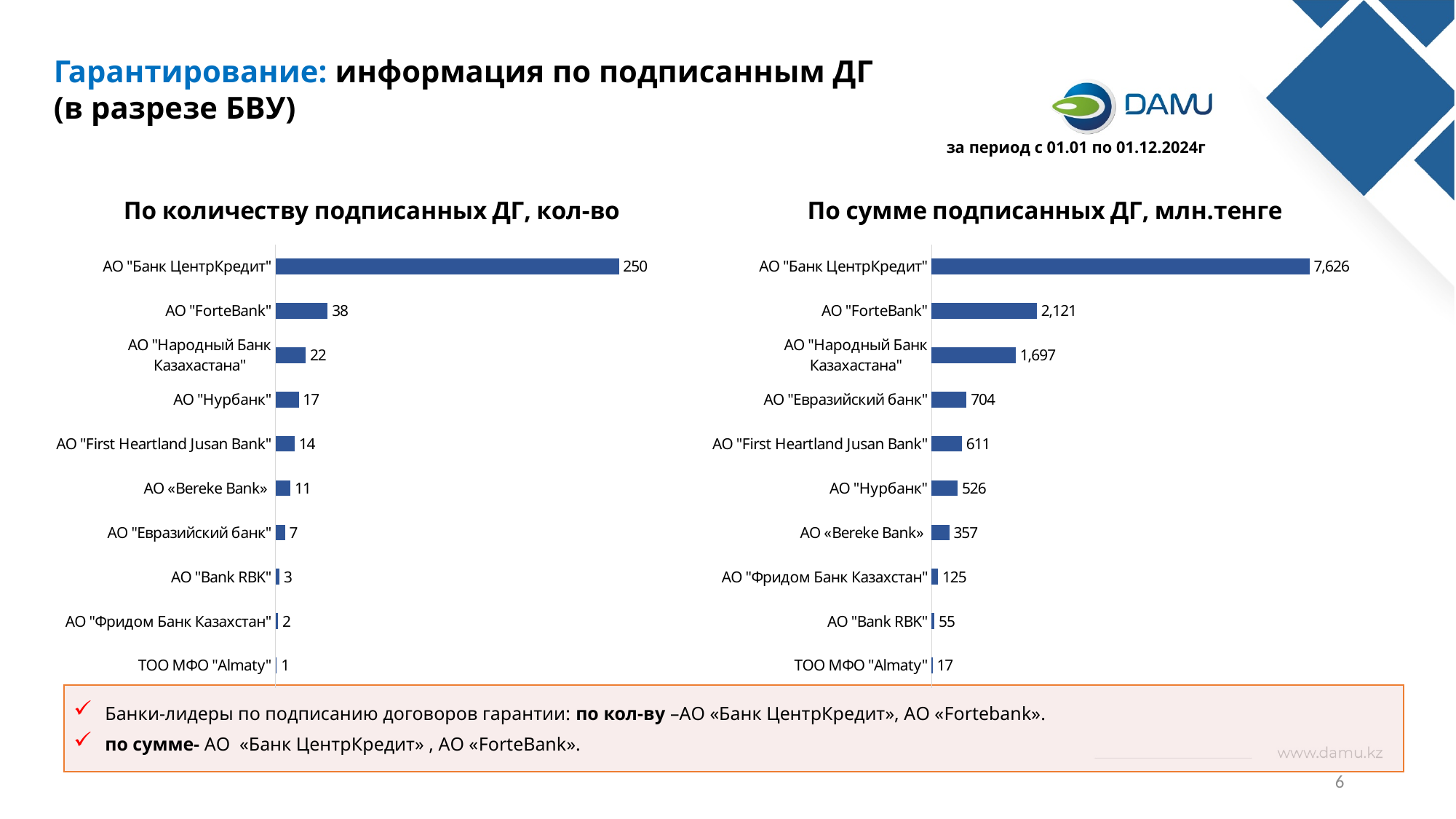
How many banks are shown in the chart "По сумме подписанных ДГ, млн.тенге"? 10 What period is stated on the slide for the data? за период с 01.01 по 01.12.2024г In the chart "По сумме подписанных ДГ, млн.тенге", what is the value for АО "Bank RBK"? 55 In the chart "По количеству подписанных ДГ, кол-во", what is the value for АО "ForteBank"? 38 In the chart "По количеству подписанных ДГ, кол-во", which is larger: АО "Нурбанк" or АО "Евразийский банк"? АО "Нурбанк" In the chart "По сумме подписанных ДГ, млн.тенге", which is larger: АО "Евразийский банк" or АО "Нурбанк"? АО "Евразийский банк" In the chart "По количеству подписанных ДГ, кол-во", what is the difference between АО "Банк ЦентрКредит" and АО "ForteBank"? 212 What kind of chart is "По количеству подписанных ДГ, кол-во"? Bar chart In the chart "По сумме подписанных ДГ, млн.тенге", what is the value for АО "Народный Банк Казахастана"? 1,697 In the chart "По сумме подписанных ДГ, млн.тенге", what is the difference between АО "ForteBank" and АО "Народный Банк Казахастана"? 424 In the chart "По сумме подписанных ДГ, млн.тенге", which bank has the lowest value? ТОО МФО "Almaty" In the chart "По количеству подписанных ДГ, кол-во", which bank has the highest value? АО "Банк ЦентрКредит"